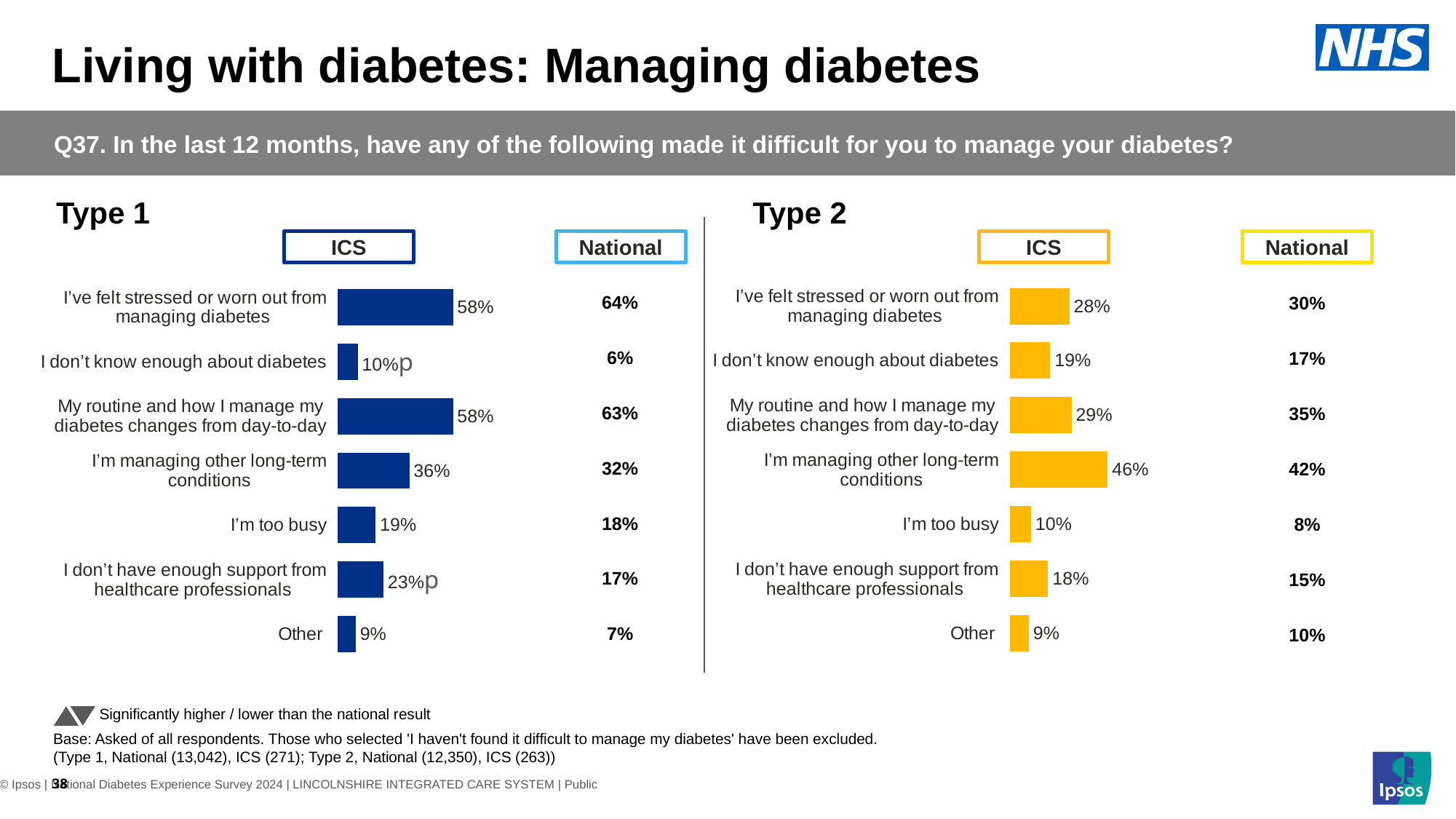
In the Type 1 chart, which category has the lowest ICS value? Other In the Type 1 chart, which is larger for "I don't have enough support from healthcare professionals": the ICS value or the National value? ICS In the Type 2 chart, which category has the highest ICS value? I'm managing other long-term conditions In the Type 2 chart, what is the ICS value for "I'm too busy"? 10% What type of chart is used for the ICS values in the Type 1 chart? Bar chart In the Type 1 chart, what is the National value for "I don't know enough about diabetes"? 6% In the Type 1 chart, what is the ICS value for "I'm managing other long-term conditions"? 36% In the Type 2 chart, what is the difference between the ICS and National values for "I'm too busy"? 2 percentage points In the Type 1 chart, what is the difference between the ICS and National values for "I've felt stressed or worn out from managing diabetes"? 6 percentage points How many categories are shown in the Type 2 chart? 7 In the Type 2 chart, which is larger for "I'm managing other long-term conditions": the ICS value or the National value? ICS In the Type 2 chart, what is the National value for "My routine and how I manage my diabetes changes from day-to-day"? 35%